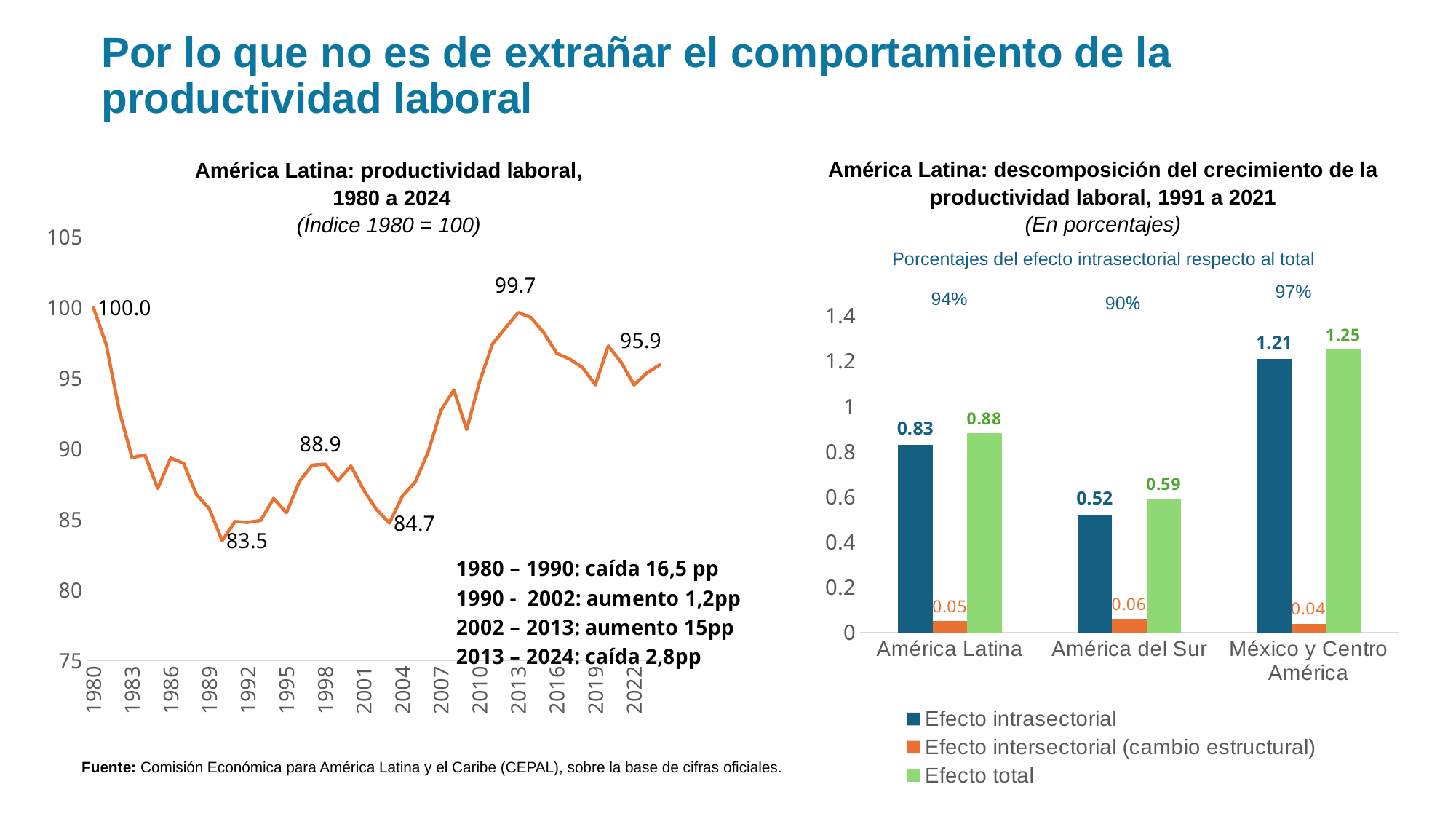
In the right chart, what is the value of 'Efecto total' for México y Centro América? 1.25 In the right chart, what is the value of 'Efecto intrasectorial' for América del Sur? 0.52 How many series does the legend of the right chart list? 3 In the right chart, what is the difference between 'Efecto total' and 'Efecto intrasectorial' for América Latina? 0.05 In the left chart, what is the last labelled value of the series, at the end of the period? 95.9 What kind of chart is the left chart, 'América Latina: productividad laboral, 1980 a 2024'? line chart In the left chart, what is the lowest value labelled on the line? 83.5 In the left chart, what is the value of the index in 1980? 100.0 In the left chart, is the value of the index in 2010 greater or less than 90? greater In the left chart, what is the highest value labelled on the line after 1980? 99.7 What kind of chart is the right chart, 'América Latina: descomposición del crecimiento de la productividad laboral, 1991 a 2021'? bar chart In the right chart, which category has the highest 'Efecto intersectorial (cambio estructural)' value? América del Sur